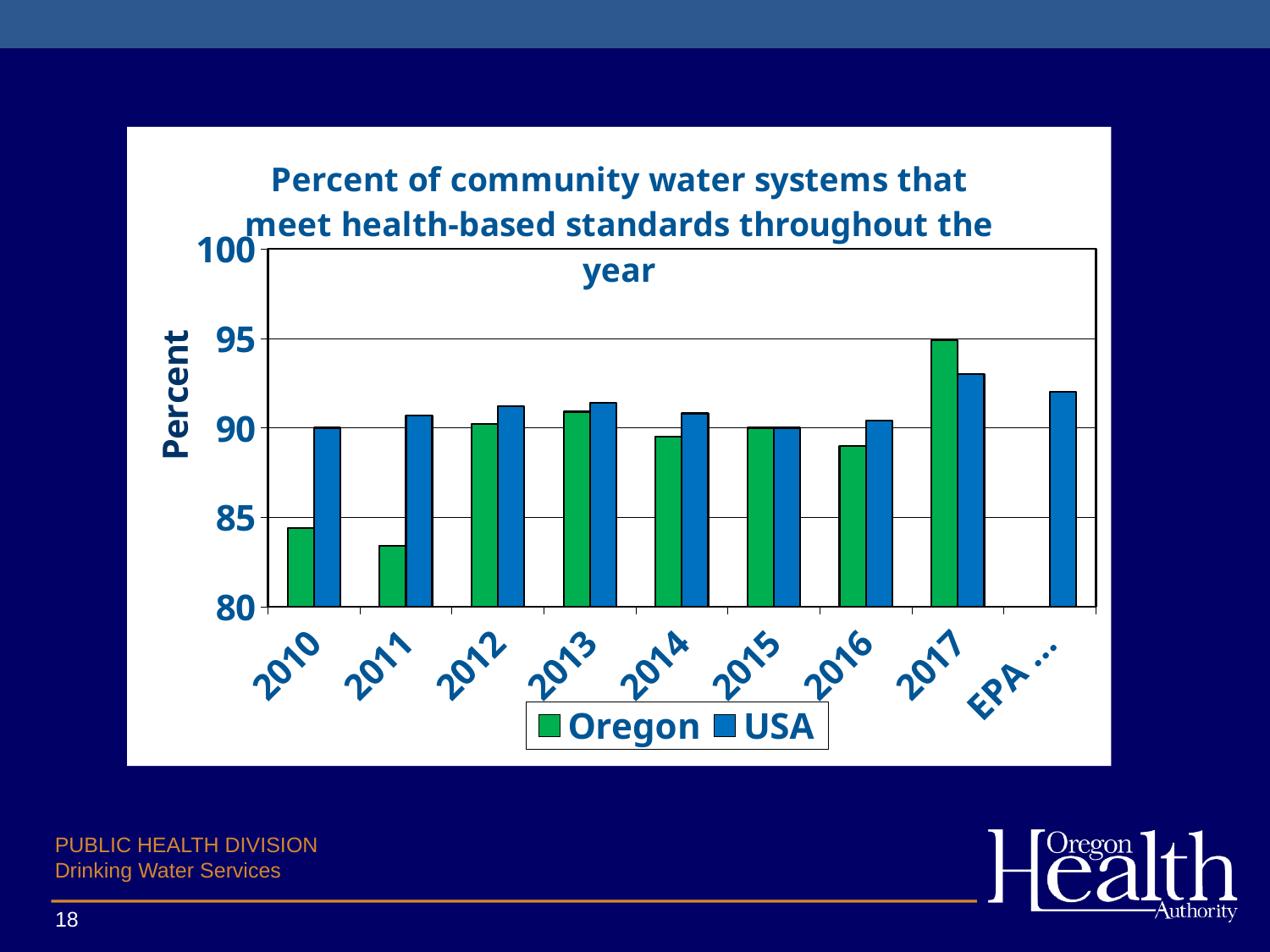
What kind of chart is shown on the slide? bar chart How many series does the legend list? 2 Is the Oregon value for 2017 greater or less than 90? greater What is the label on the vertical axis? Percent In which year is the Oregon value lowest? 2011 Is the Oregon value for 2016 greater or less than 90? less Do the USA values rise or fall from 2010 to 2013? rise In 2017, which is larger, the Oregon value or the USA value? Oregon What are the two series named in the legend? Oregon and USA In 2010, which is larger, the Oregon value or the USA value? USA Is the Oregon value for 2010 greater or less than 85? less In which year is the Oregon value highest? 2017